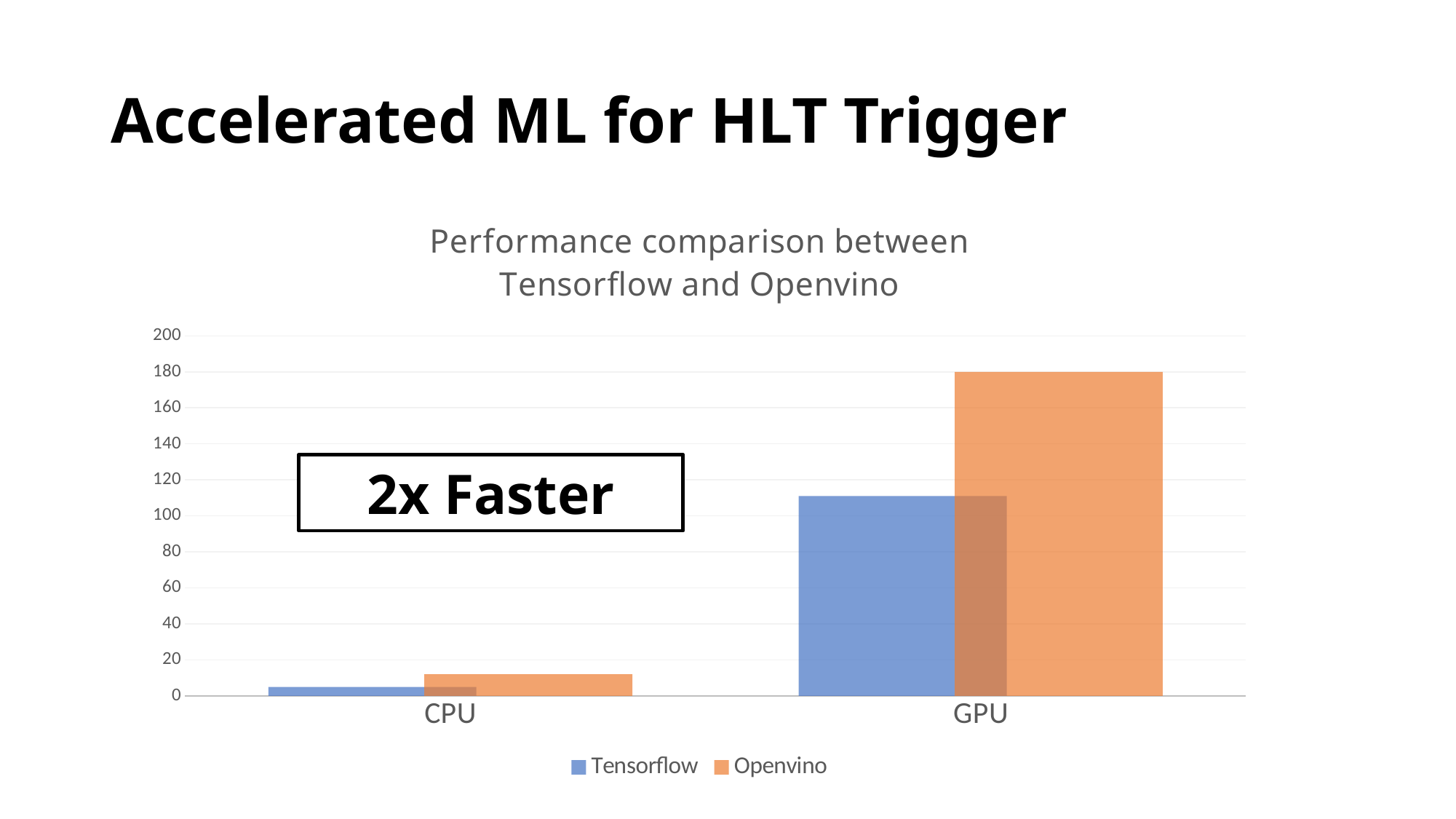
Is the Tensorflow value for GPU greater or less than 100? greater What is the Openvino value for GPU? 180 Is the Openvino value for CPU greater or less than 20? less What is the title of the chart? Performance comparison between Tensorflow and Openvino Which series has the larger value for GPU, Tensorflow or Openvino? Openvino Which bar is the tallest in the chart? Openvino for GPU How many series does the legend list? 2 Which colour represents the Tensorflow series? blue Which series has the larger value for CPU, Tensorflow or Openvino? Openvino How many categories are shown on the x axis? 2 Is the Tensorflow value for GPU greater or less than 120? less What kind of chart is shown on the slide? bar chart